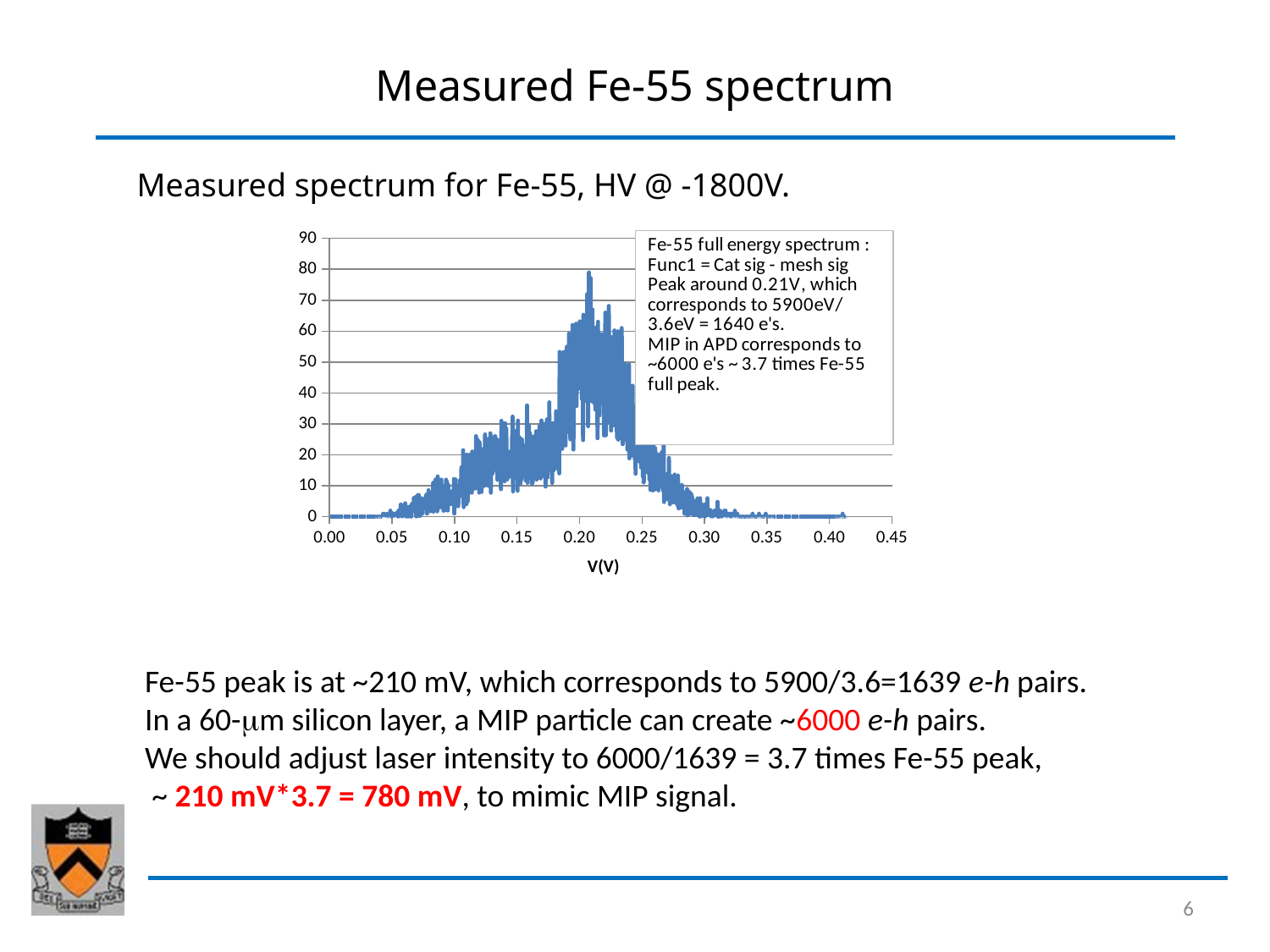
According to the text box on the chart, what voltage does the Fe-55 peak correspond to? 0.21V Around which x-axis value does the spectrum reach its peak? 0.21 Is the value of the spectrum higher at 0.20 V or at 0.30 V? 0.20 V What is the highest value shown on the y axis of the chart? 90 Is the peak value of the spectrum greater or less than 70? greater Does the spectrum rise or fall between 0.25 V and 0.35 V on the x axis? fall Is the value of the spectrum at 0.05 V greater or less than 10? less Does the spectrum rise or fall between 0.05 V and 0.20 V on the x axis? rise Is the value of the spectrum at 0.40 V greater or less than 10? less What is the label of the x axis of the chart? V(V) What kind of chart is shown on the slide? line chart